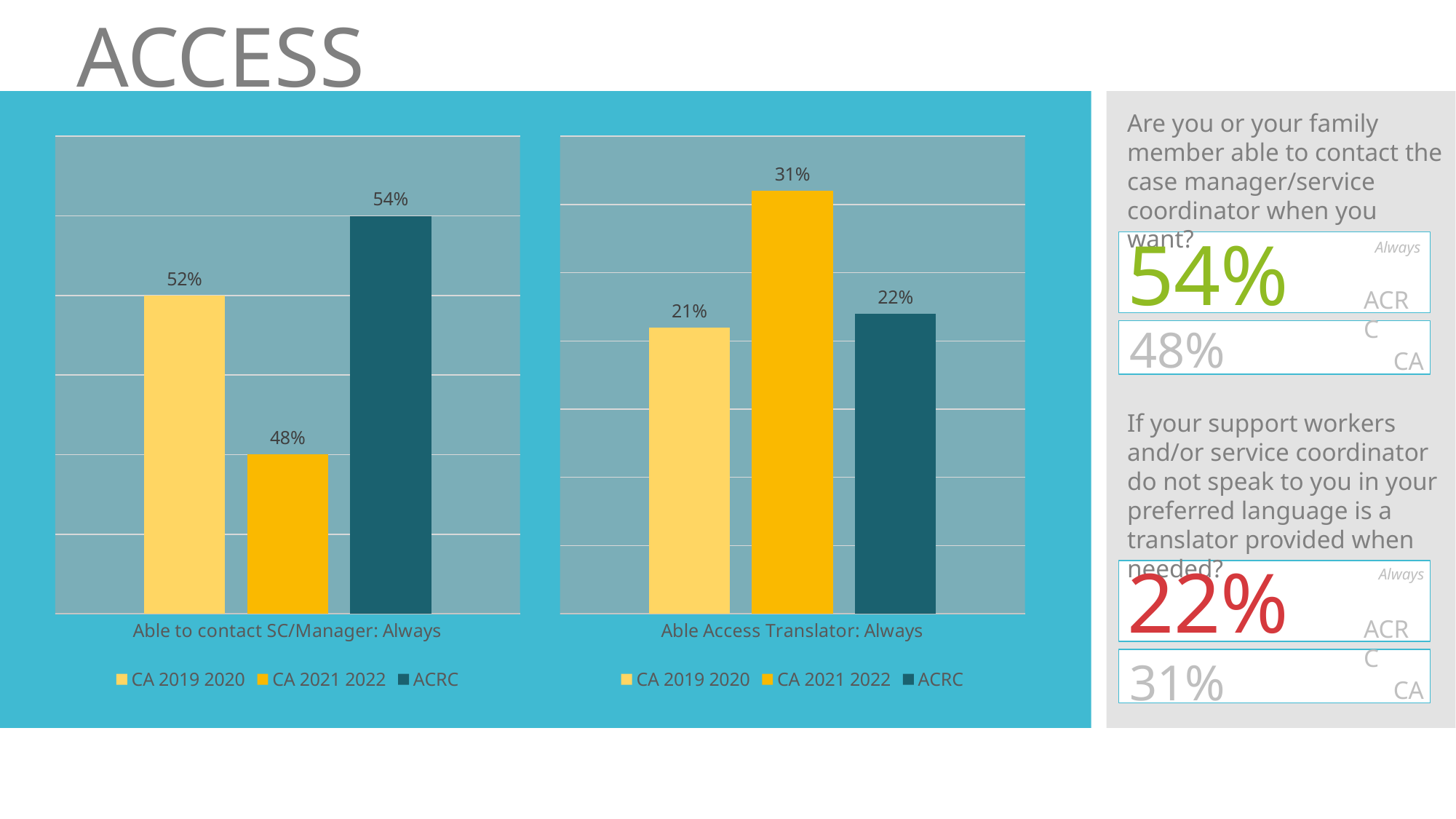
In the left chart (Able to contact SC/Manager: Always), what is the difference between the ACRC value and the CA 2021 2022 value? 6% In the right chart (Able Access Translator: Always), what is the value for CA 2019 2020? 21% What kind of chart is the right chart (Able Access Translator: Always)? Bar chart In the right chart (Able Access Translator: Always), what is the difference between the CA 2021 2022 value and the ACRC value? 9% In the left chart (Able to contact SC/Manager: Always), which series has the lowest value? CA 2021 2022 In the left chart (Able to contact SC/Manager: Always), what is the value for CA 2021 2022? 48% How many series does the legend of the left chart (Able to contact SC/Manager: Always) list? 3 In the right chart (Able Access Translator: Always), which series has the lowest value? CA 2019 2020 In the right chart (Able Access Translator: Always), which series has the highest value? CA 2021 2022 In the left chart (Able to contact SC/Manager: Always), what is the value for ACRC? 54% In the right chart (Able Access Translator: Always), which is larger: the ACRC value or the CA 2019 2020 value? ACRC In the left chart (Able to contact SC/Manager: Always), what colour is the ACRC bar? Dark teal